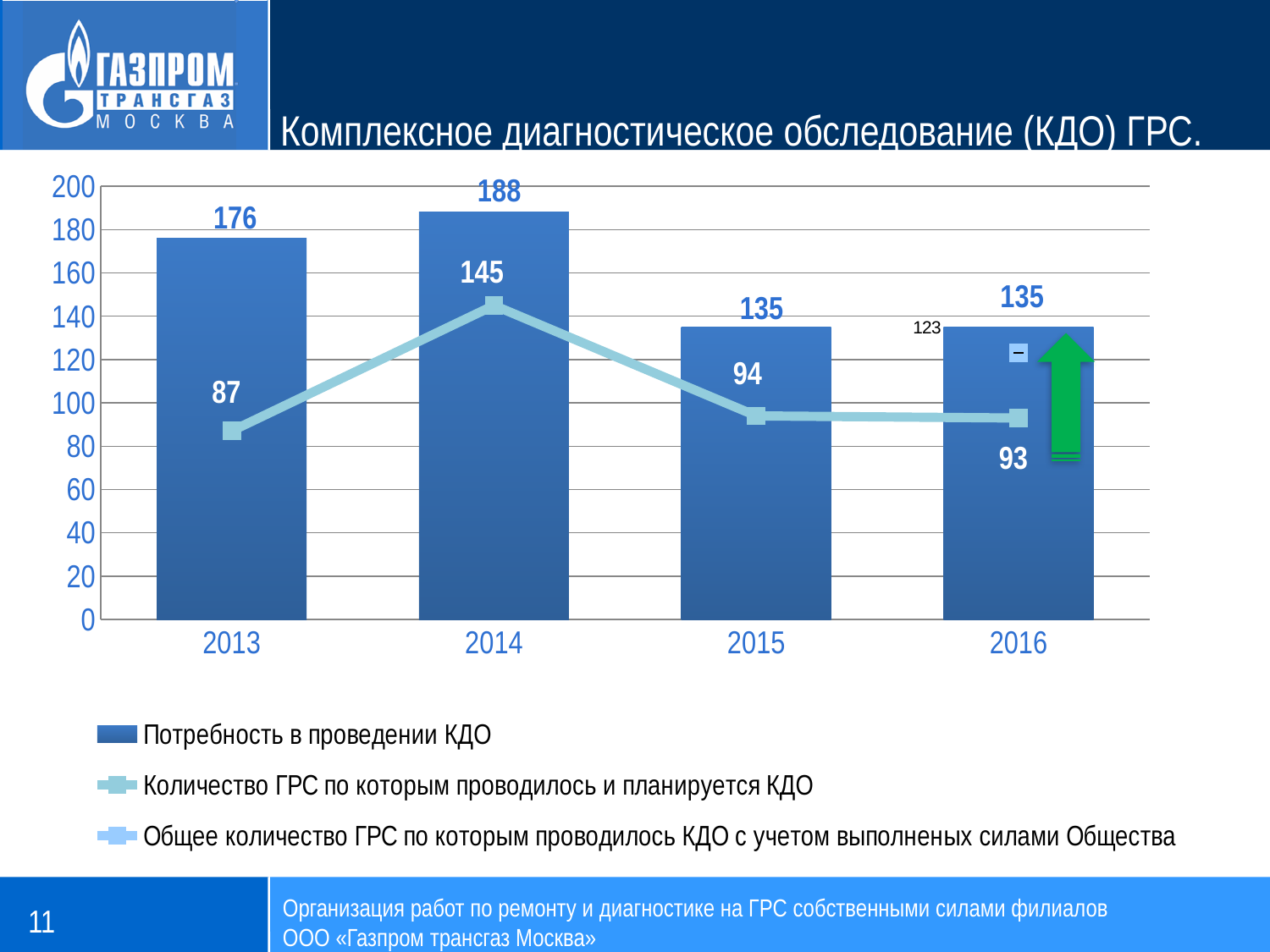
What kind of chart is this? Combined bar and line chart Which is larger: the bar value for 2013 or the bar value for 2015? 2013 In which year is the bar "Потребность в проведении КДО" highest? 2014 In which year is the line "Количество ГРС по которым проводилось и планируется КДО" lowest? 2013 Does the line "Количество ГРС по которым проводилось и планируется КДО" rise or fall from 2014 to 2015? Fall How many years are shown on the x axis? 4 What value is shown for the series "Общее количество ГРС по которым проводилось КДО с учетом выполненых силами Общества" in 2016? 123 What is the value of the bar for 2014? 188 What is the value of the bar "Потребность в проведении КДО" for 2016? 135 How many series does the legend list? 3 What is the value of the line series "Количество ГРС по которым проводилось и планируется КДО" in 2013? 87 What is the difference between the bar value and the line value in 2014 (188 and 145)? 43